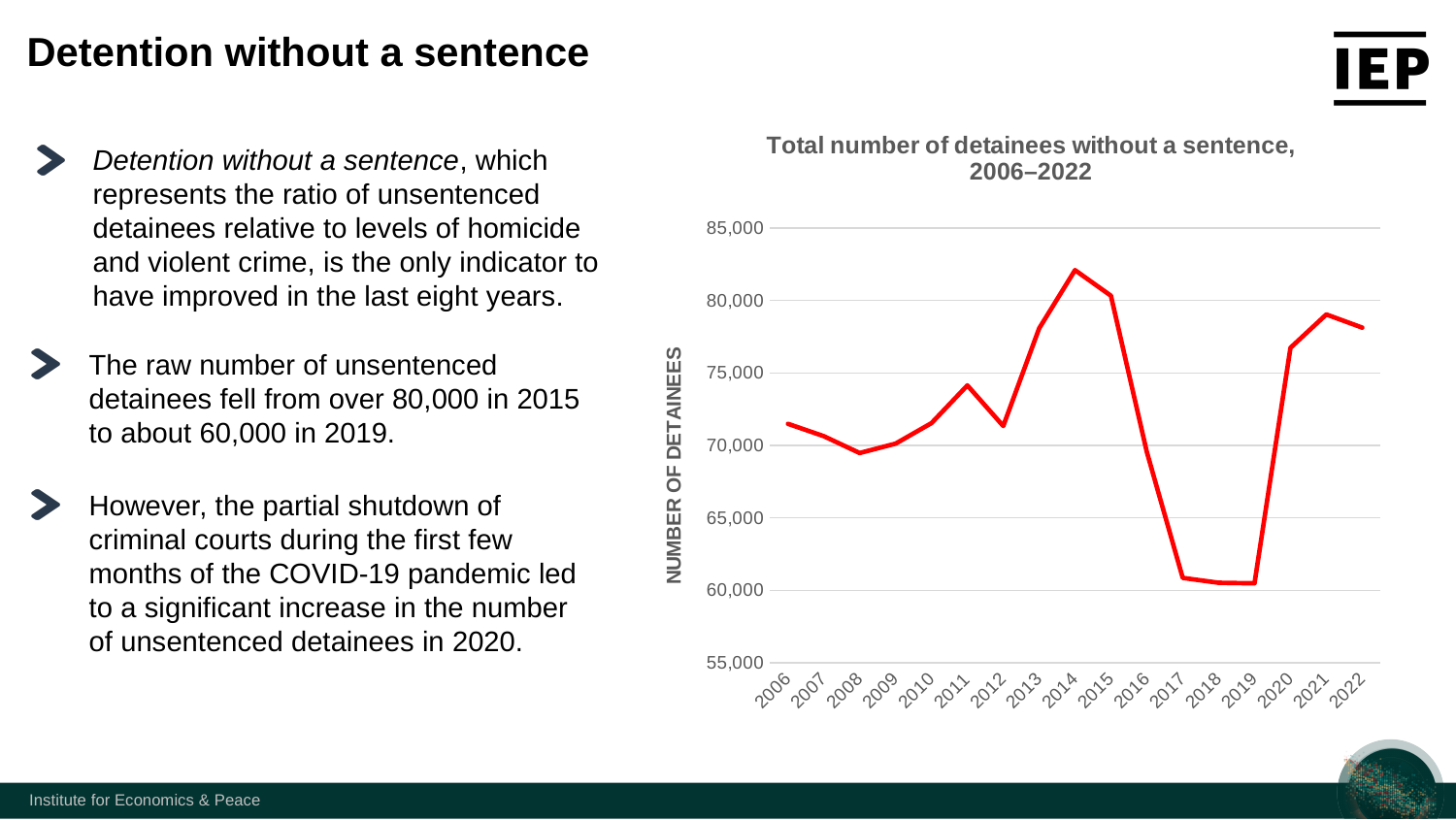
How many years are plotted along the x axis of the chart? 17 Which year has the larger number of detainees, 2020 or 2019? 2020 Do the values rise or fall between 2015 and 2017? fall What is the label on the y axis of the chart? NUMBER OF DETAINEES Which year has the highest number of detainees without a sentence? 2014 Is the value for 2021 greater or less than 75,000? greater Is the value for 2014 greater or less than 80,000? greater Is the value for 2019 greater or less than 65,000? less Which year has the larger number of detainees, 2014 or 2008? 2014 What is the title of the chart? Total number of detainees without a sentence, 2006–2022 What kind of chart is shown on the slide? line chart